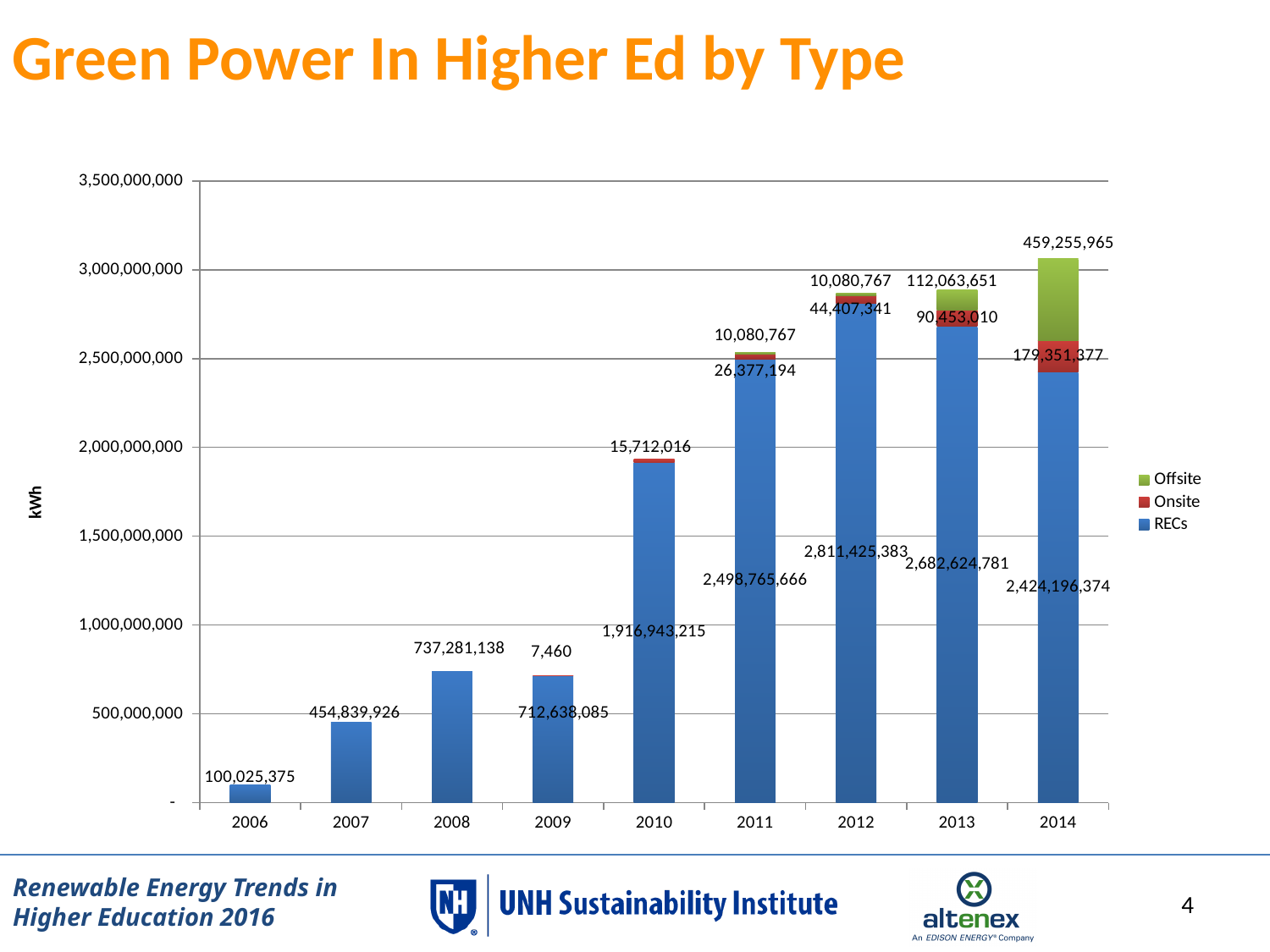
What is the RECs value for 2006? 100,025,375 Is the total for 2008 greater or less than 500,000,000? greater Which is larger, the Offsite value for 2013 or the Offsite value for 2014? 2014 What is the Onsite value for 2013? 90,453,010 What is the total of the stacked bar for 2014? 3,062,803,716 How many years are shown on the x axis? 9 Which year has the lowest RECs value? 2006 How many series does the legend list? 3 Which year has the highest RECs value? 2012 What is the difference between the RECs values for 2012 and 2011? 312,659,717 What is the Offsite value for 2014? 459,255,965 What kind of chart is shown on the slide? Stacked bar chart